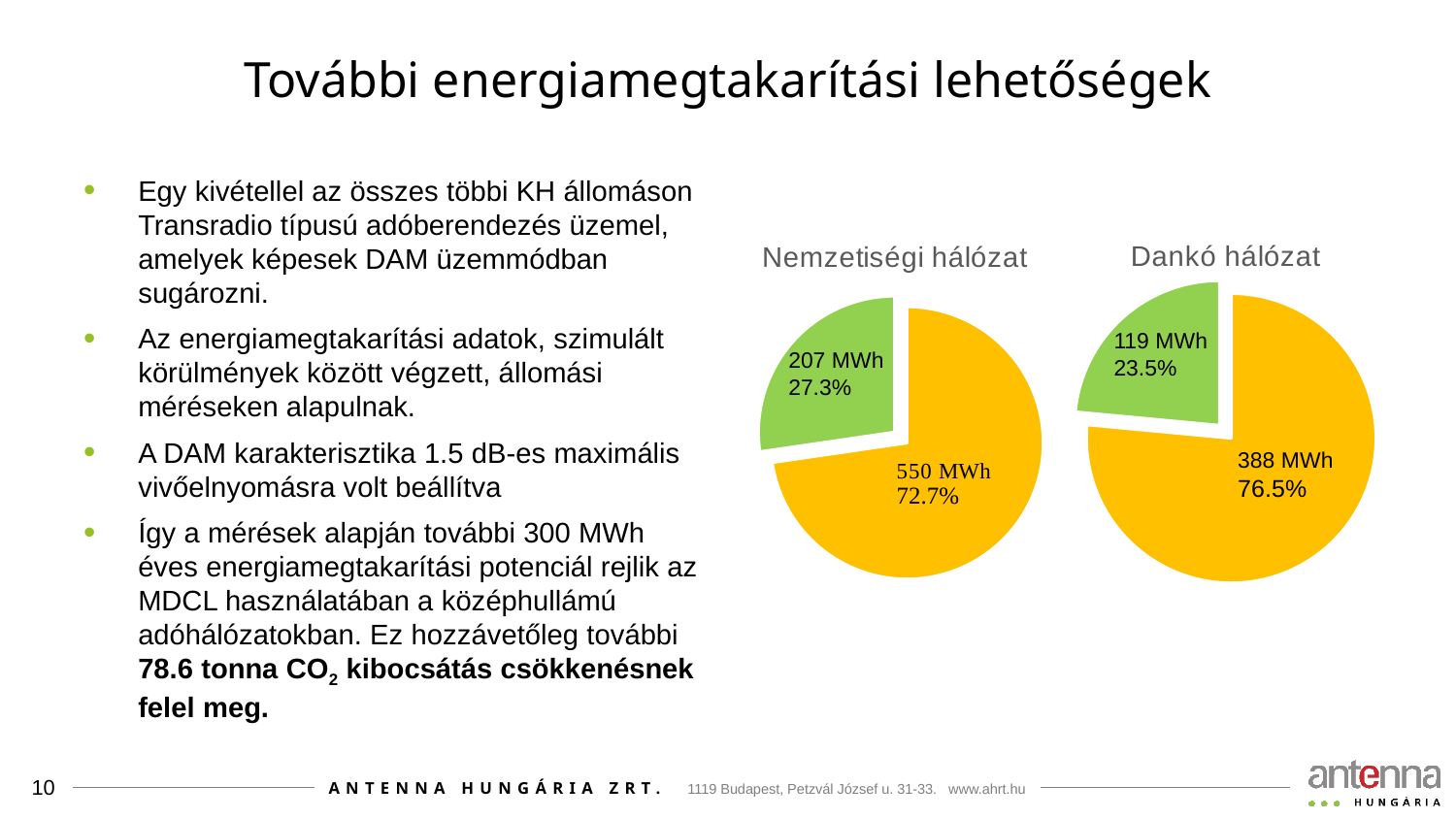
In the Nemzetiségi hálózat pie chart, what value is shown on the larger (yellow) slice? 550 MWh In the Nemzetiségi hálózat pie chart, what value is shown on the smaller (green) slice? 207 MWh In the Dankó hálózat pie chart, what share of the pie does the green slice represent? 23.5% In the Nemzetiségi hálózat pie chart, what is the difference in MWh between the yellow slice and the green slice? 343 MWh In the Dankó hálózat pie chart, what is the difference in MWh between the yellow slice and the green slice? 269 MWh Which pie chart has the larger green slice in MWh, Nemzetiségi hálózat or Dankó hálózat? Nemzetiségi hálózat In the Nemzetiségi hálózat pie chart, what share of the pie does the yellow slice represent? 72.7% In the Nemzetiségi hálózat pie chart, what share of the pie does the green slice represent? 27.3% In the Dankó hálózat pie chart, what value is shown on the larger (yellow) slice? 388 MWh What type of chart is used for the Nemzetiségi hálózat? Pie chart In the Dankó hálózat pie chart, what value is shown on the smaller (green) slice? 119 MWh How many slices does the Dankó hálózat pie chart have? 2